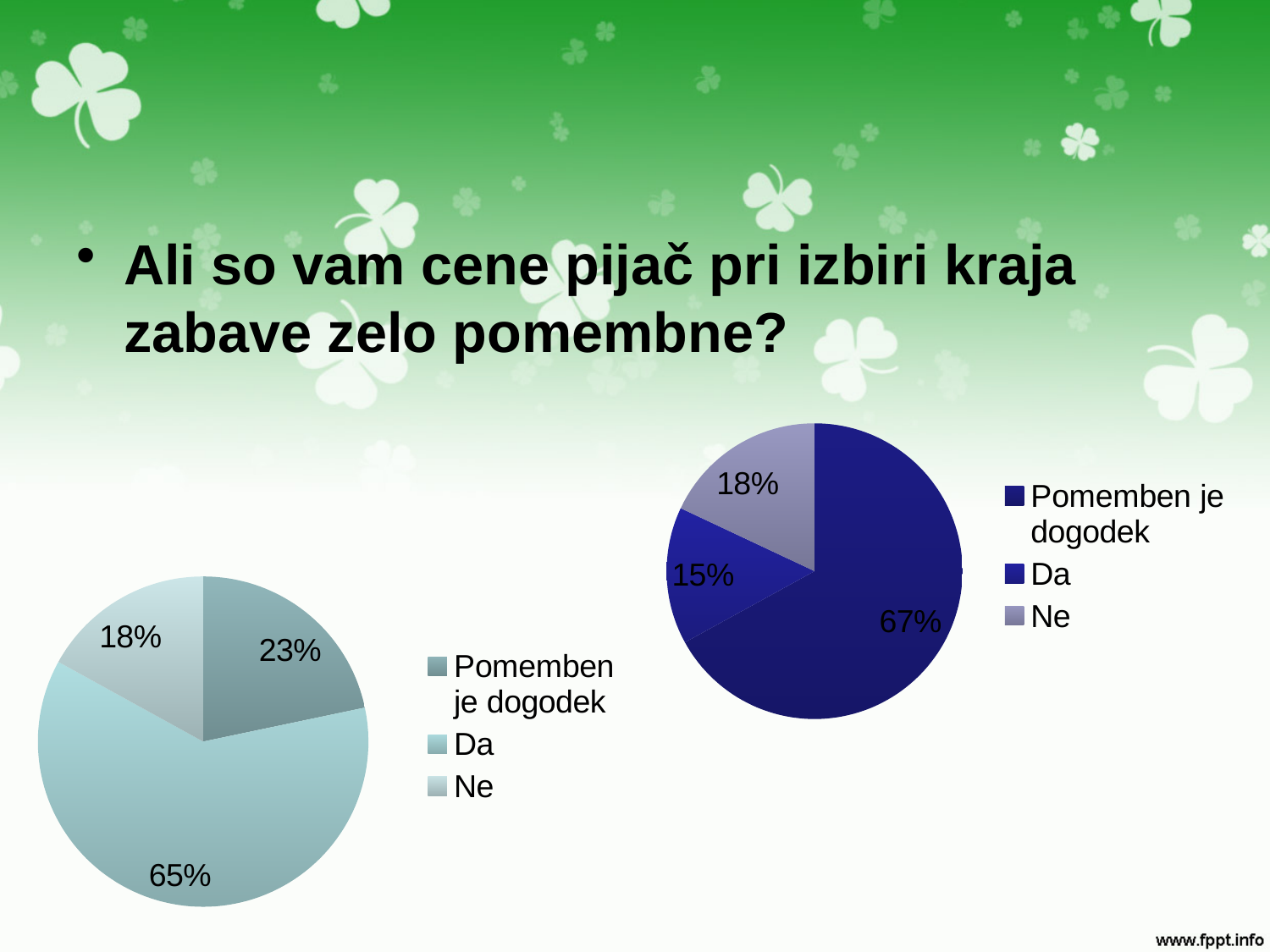
In the right pie chart, what is the value for Ne? 18% In the left pie chart, what is the difference between the values for Da and Pomemben je dogodek? 42% In the left pie chart, which category has the smallest slice? Ne In the left pie chart, what is the value for Da? 65% In the left pie chart, which category has the largest slice? Da In the right pie chart, what is the value for Pomemben je dogodek? 67% In the right pie chart, which category has the smallest slice? Da In the left pie chart, what is the value for Pomemben je dogodek? 23% How many slices does the right pie chart have? 3 What type of chart is the left chart on the slide? Pie chart In the right pie chart, which is larger, the value for Ne or the value for Da? Ne In the right pie chart, what is the value for Da? 15%